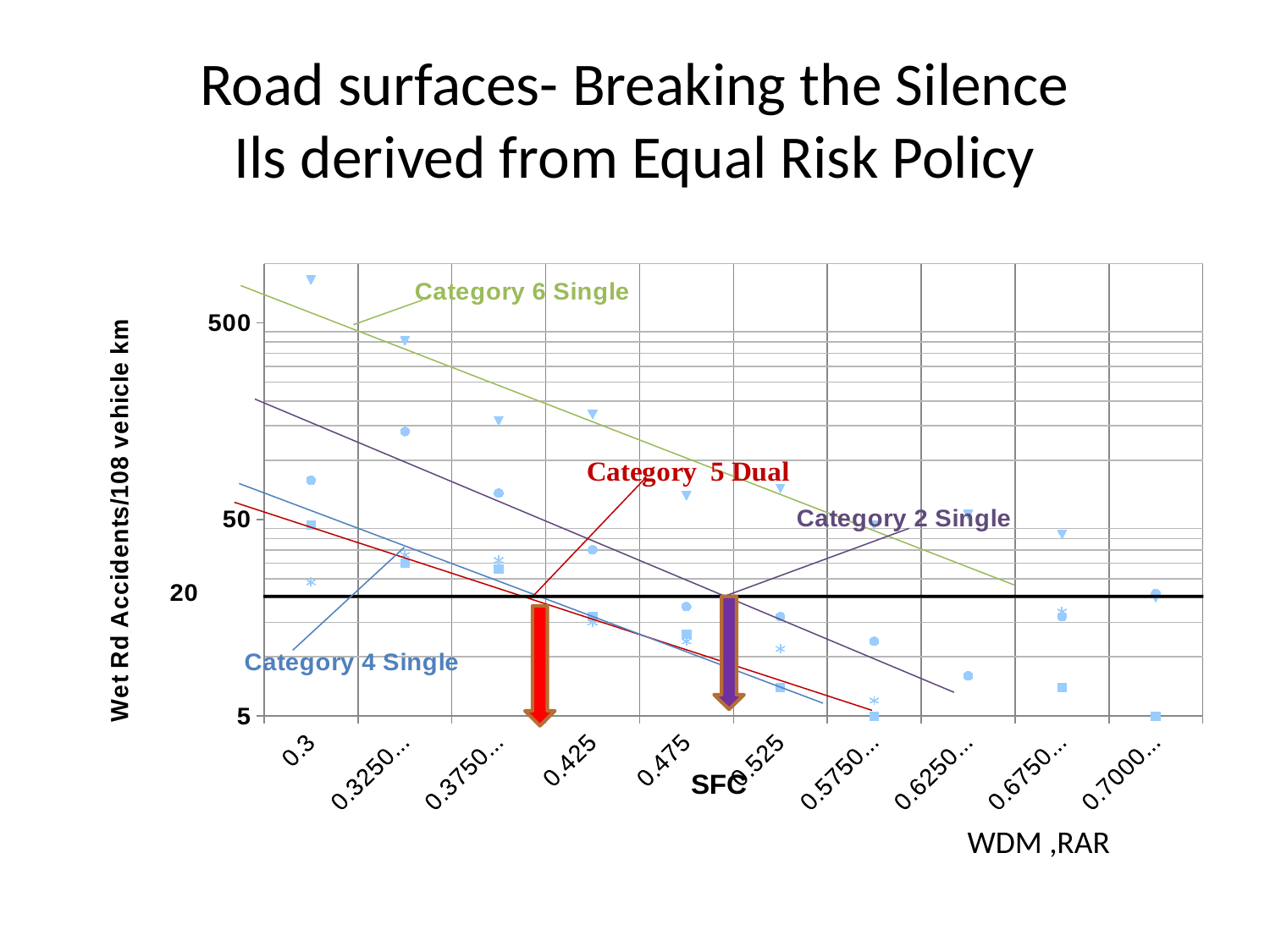
Is the highest plotted point at SFC 0.3 greater or less than 500? greater Which labelled category has the highest trend line on the chart? Category 6 Single Is the value of the Category 6 Single trend line at SFC 0.3 greater or less than 500? greater Which is higher at SFC 0.3: the Category 2 Single trend line or the Category 4 Single trend line? Category 2 Single Is the value of the Category 4 Single trend line at SFC 0.3 greater or less than 50? greater What is the lowest value shown on the y axis of the chart? 5 What is the title of the y axis of the chart? Wet Rd Accidents/108 vehicle km What is the title of the x axis of the chart? SFC How many road category trend lines are labelled on the chart? 4 Do the trend lines on the chart rise or fall as SFC increases along the x axis? fall What kind of chart is shown on the slide? scatter chart At what value on the y axis is the horizontal black reference line drawn? 20